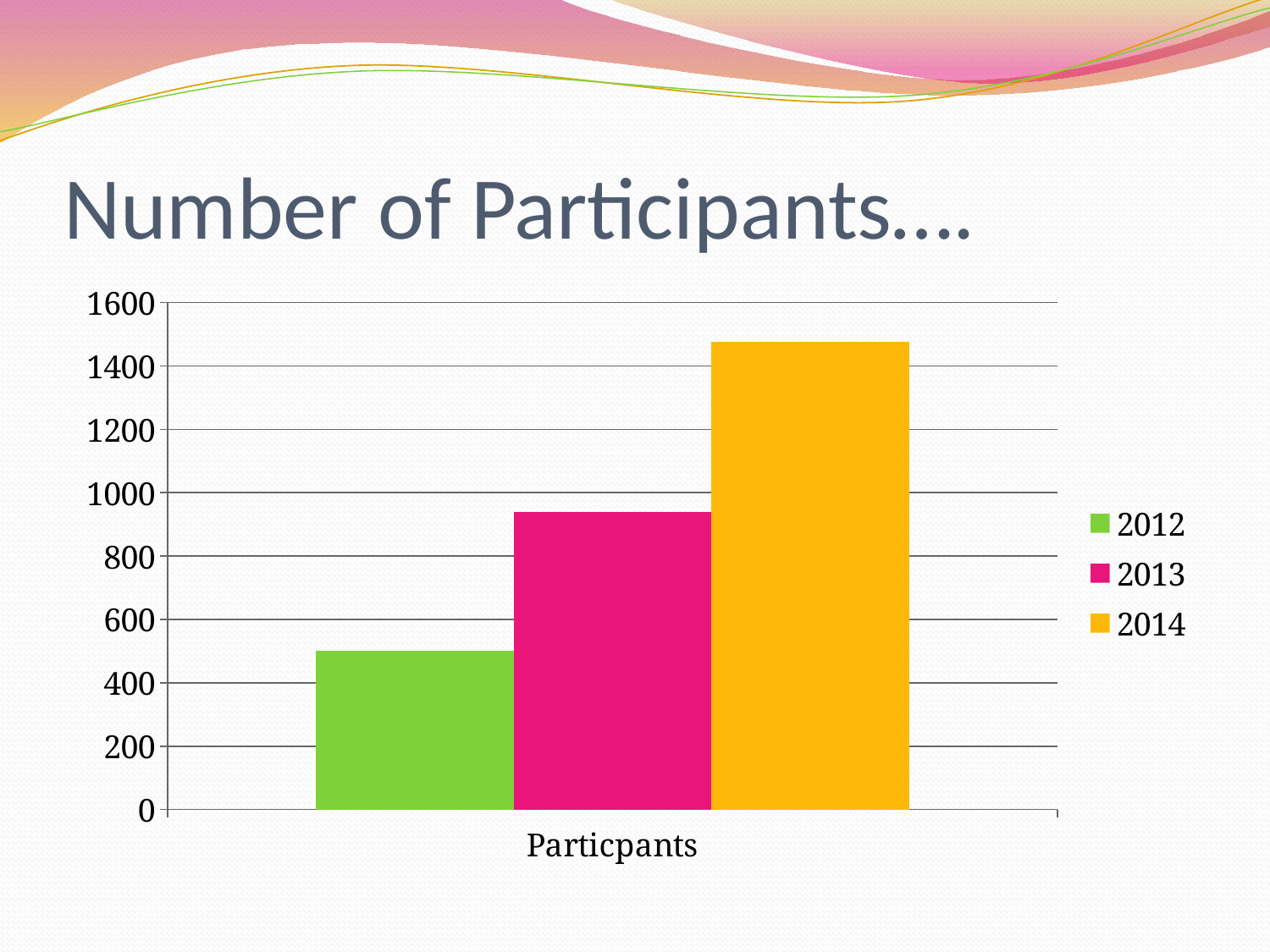
Do the participant numbers rise or fall from 2012 to 2014? rise Is the value for 2012 greater or less than 400? greater Is the value for 2014 greater or less than 1400? greater What colour is the bar for 2013? pink What is the title of the slide? Number of Participants.... Is the value for 2013 greater or less than 1000? less Which is larger, the value for 2013 or the value for 2012? 2013 How many series does the legend list? 3 Which year has the highest number of participants? 2014 Which year has the lowest number of participants? 2012 How many categories are shown on the x axis? 1 What kind of chart is shown on the slide? bar chart